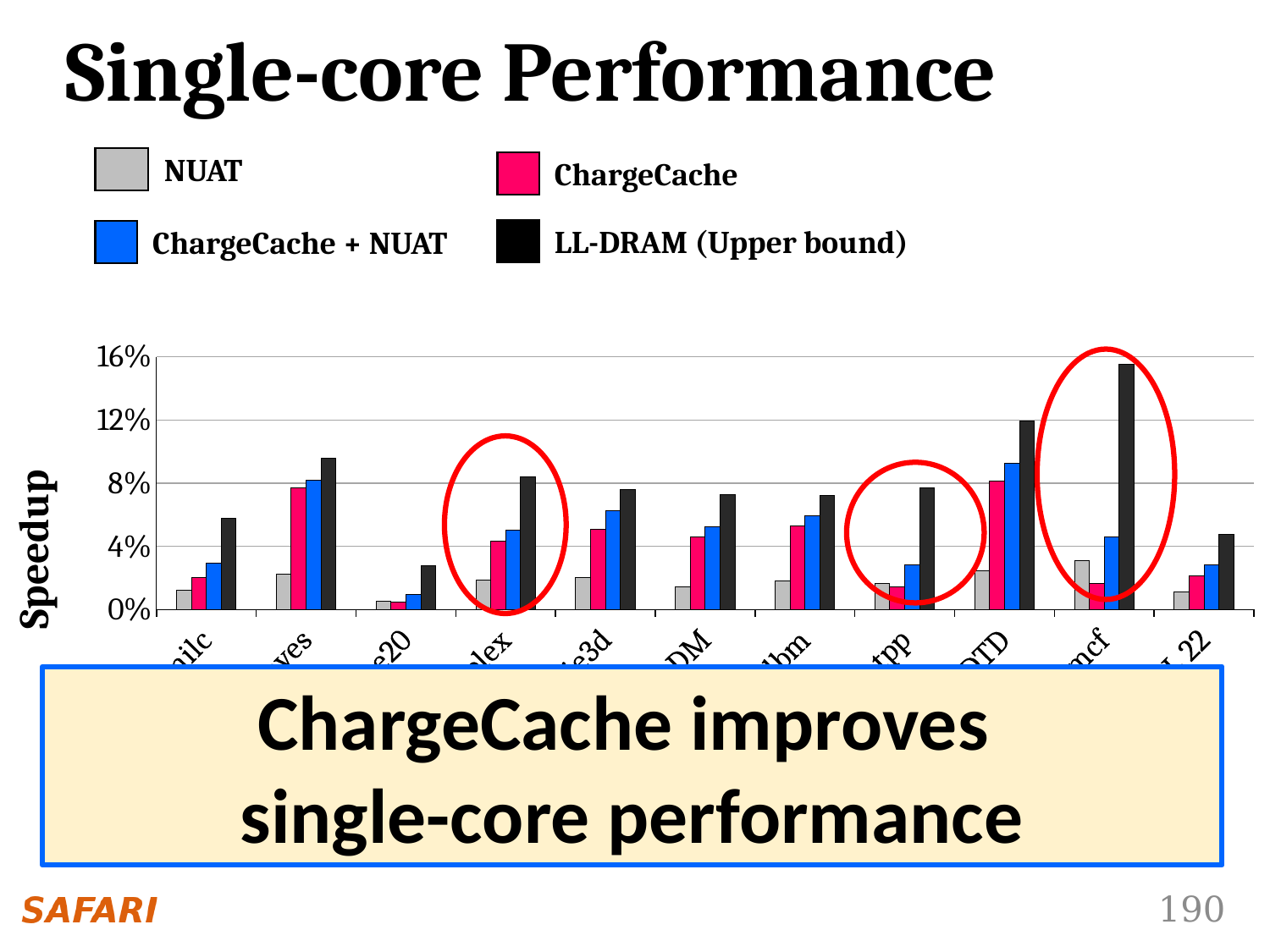
How many series does the legend list? 4 Which series has the tallest bar in every category group? LL-DRAM (Upper bound) Is the LL-DRAM (Upper bound) value in the tenth category group from the left greater or less than 12%? greater Is the LL-DRAM (Upper bound) value in the second category group from the left greater or less than 8%? greater Is the NUAT value in the third category group from the left greater or less than 4%? less How many category groups are plotted along the x axis? 11 In the ninth category group from the left, which is larger: the ChargeCache + NUAT bar or the ChargeCache bar? ChargeCache + NUAT In the second category group from the left, which is larger: the ChargeCache bar or the NUAT bar? ChargeCache What are the four series named in the legend? NUAT, ChargeCache, ChargeCache + NUAT, LL-DRAM (Upper bound) What is the label on the y axis? Speedup What kind of chart is shown on the slide? bar chart